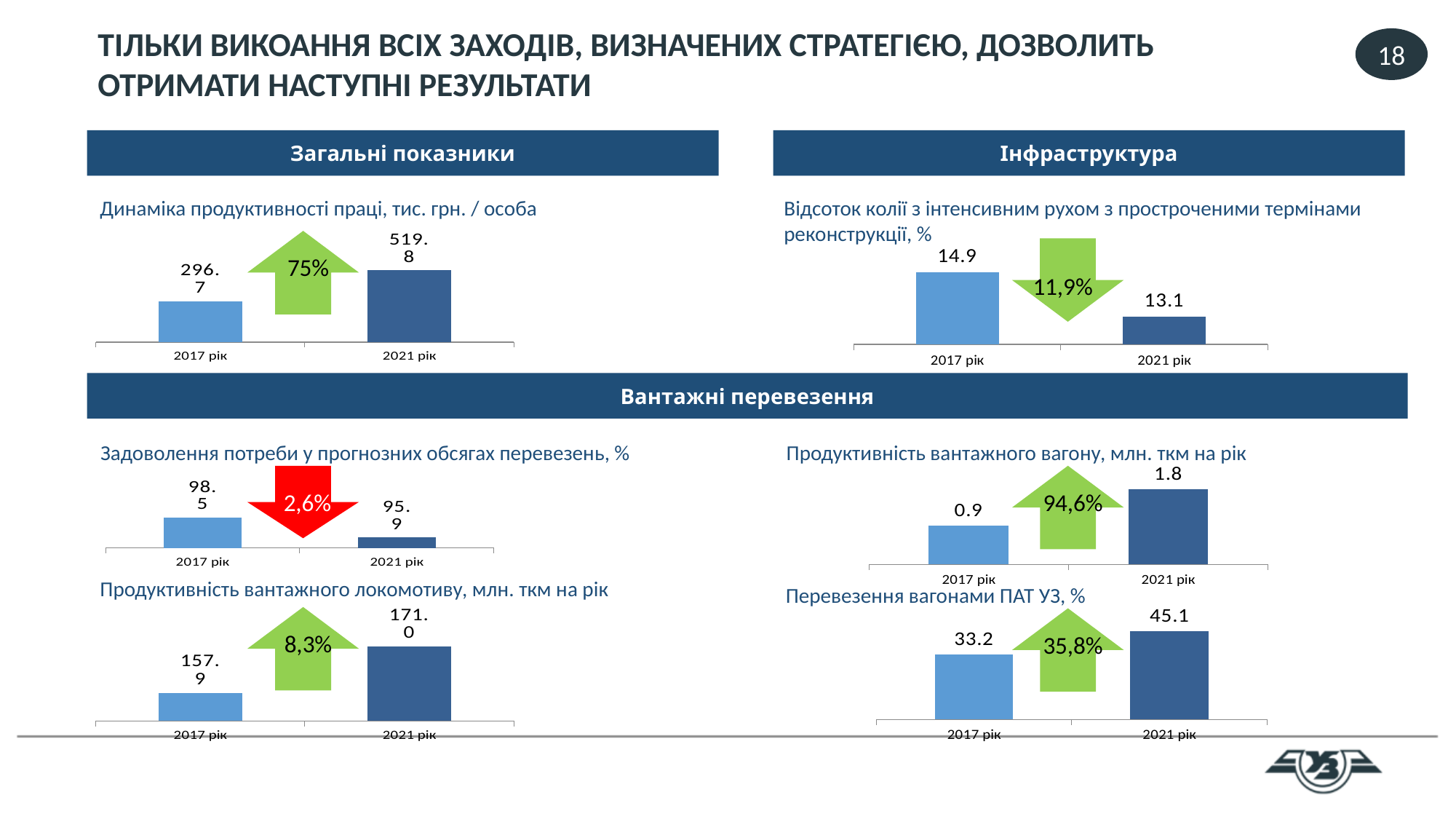
In the chart 'Продуктивність вантажного вагону, млн. ткм на рік', what is the value for 2021 рік? 1.8 What kind of chart is 'Продуктивність вантажного локомотиву, млн. ткм на рік'? Bar chart In the chart 'Перевезення вагонами ПАТ УЗ, %', which year has the higher value? 2021 рік In the chart 'Динаміка продуктивності праці, тис. грн. / особа', what is the value for 2021 рік? 519.8 In the chart 'Задоволення потреби у прогнозних обсягах перевезень, %', which year has the lower value? 2021 рік In the chart 'Продуктивність вантажного локомотиву, млн. ткм на рік', what is the difference between the 2021 рік and 2017 рік values? 13.1 In the chart 'Відсоток колії з інтенсивним рухом з простроченими термінами реконструкції, %', what is the value for 2017 рік? 14.9 In the chart 'Перевезення вагонами ПАТ УЗ, %', what is the value for 2017 рік? 33.2 In the chart 'Задоволення потреби у прогнозних обсягах перевезень, %', what is the value for 2021 рік? 95.9 How many bars are shown in the chart 'Продуктивність вантажного вагону, млн. ткм на рік'? 2 In the chart 'Динаміка продуктивності праці, тис. грн. / особа', what is the value for 2017 рік? 296.7 In the chart 'Відсоток колії з інтенсивним рухом з простроченими термінами реконструкції, %', what is the difference between the 2017 рік and 2021 рік values? 1.8